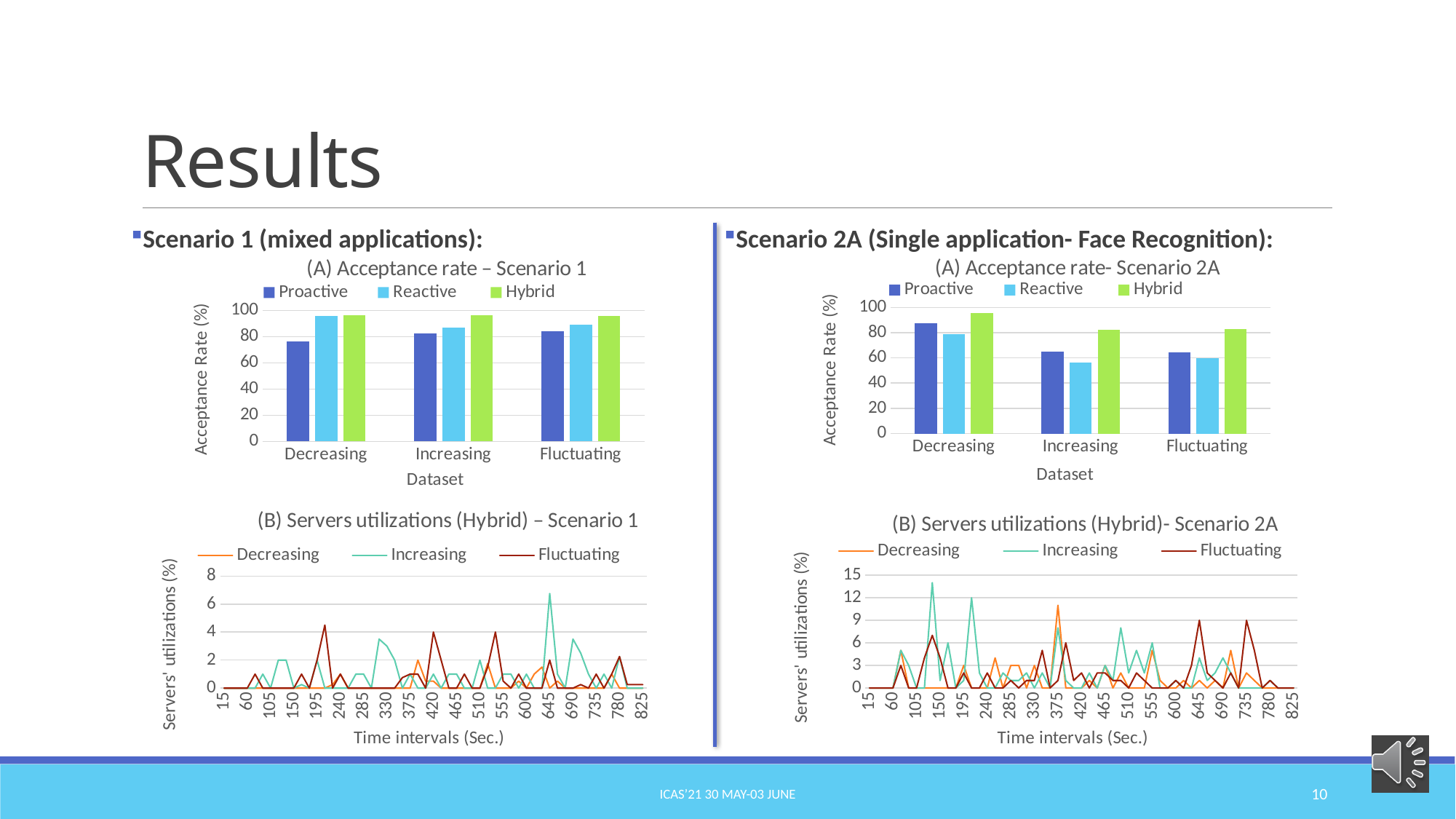
In the chart titled "(A) Acceptance rate- Scenario 2A", which series has the highest acceptance rate for the Fluctuating dataset? Hybrid In the chart titled "(B) Servers utilizations (Hybrid) – Scenario 1", what kind of chart is it? line chart In the chart titled "(A) Acceptance rate – Scenario 1", what kind of chart is it? bar chart In the chart titled "(B) Servers utilizations (Hybrid) – Scenario 1", which series reaches the highest peak value? Increasing In the chart titled "(A) Acceptance rate- Scenario 2A", is the Reactive value for Increasing greater or less than 60? less In the chart titled "(A) Acceptance rate- Scenario 2A", how many dataset categories are shown on the x axis? 3 In the chart titled "(A) Acceptance rate- Scenario 2A", is the Hybrid value for Decreasing greater or less than 80? greater In the chart titled "(B) Servers utilizations (Hybrid)- Scenario 2A", what is the x-axis title? Time intervals (Sec.) In the chart titled "(A) Acceptance rate – Scenario 1", which series has the lowest acceptance rate for the Decreasing dataset? Proactive In the chart titled "(A) Acceptance rate- Scenario 2A", for the Decreasing dataset, which is larger: Proactive or Reactive? Proactive In the chart titled "(A) Acceptance rate – Scenario 1", is the Proactive value for Decreasing greater or less than 80? less In the chart titled "(A) Acceptance rate – Scenario 1", how many series does the legend list? 3